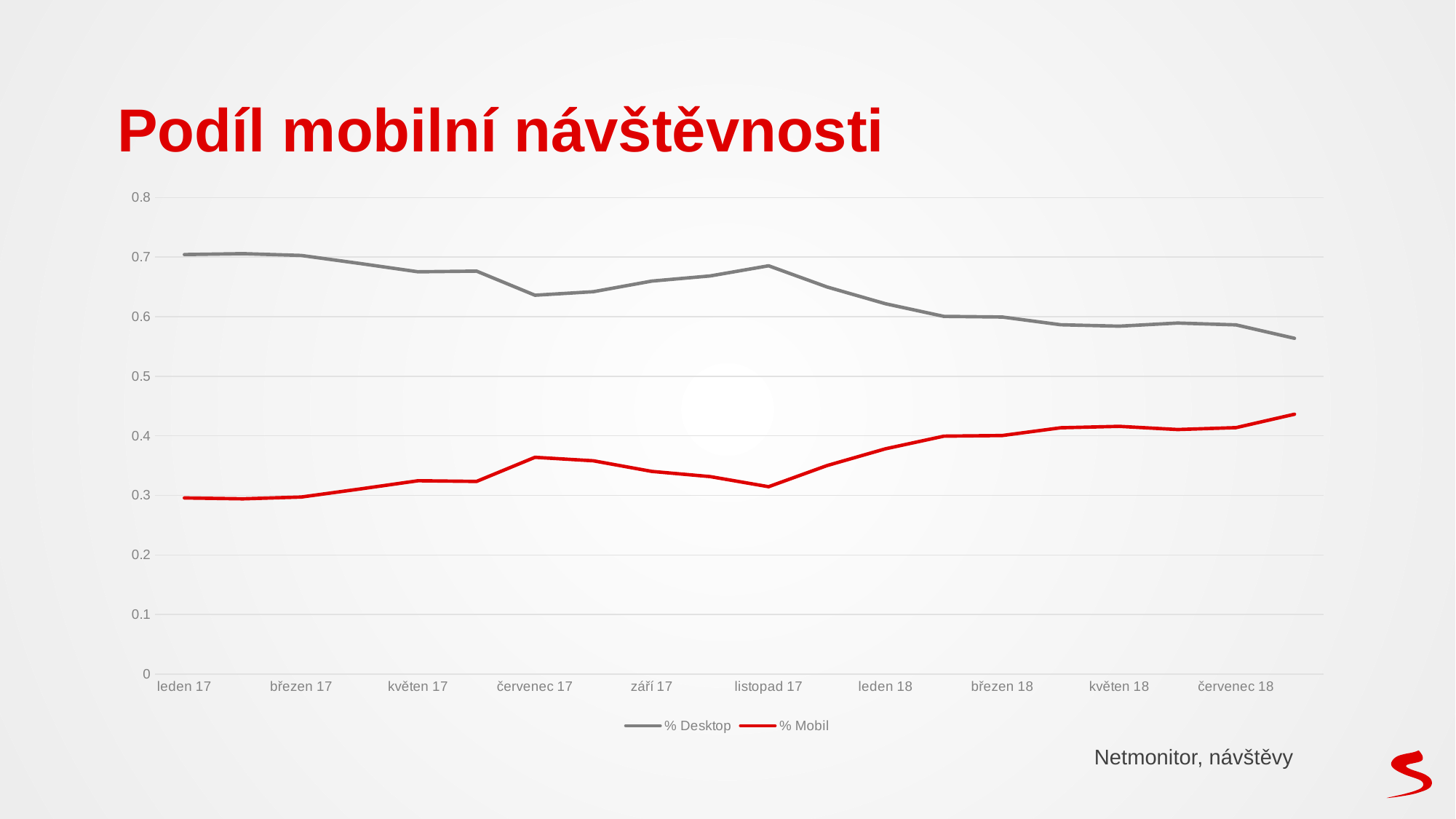
Does the % Desktop series generally rise or fall from leden 17 to červenec 18? fall Is the value for % Desktop at březen 18 greater or less than 0.5? greater Which is larger at leden 17, % Desktop or % Mobil? % Desktop Which series is drawn in red? % Mobil Is the value for % Mobil at leden 18 greater or less than 0.4? less How many series does the legend list? 2 Is the value for % Mobil at září 17 greater or less than 0.4? less What kind of chart is shown on the slide? line chart What is the title of the chart on the slide? Podíl mobilní návštěvnosti Does the % Mobil series generally rise or fall from leden 17 to červenec 18? rise